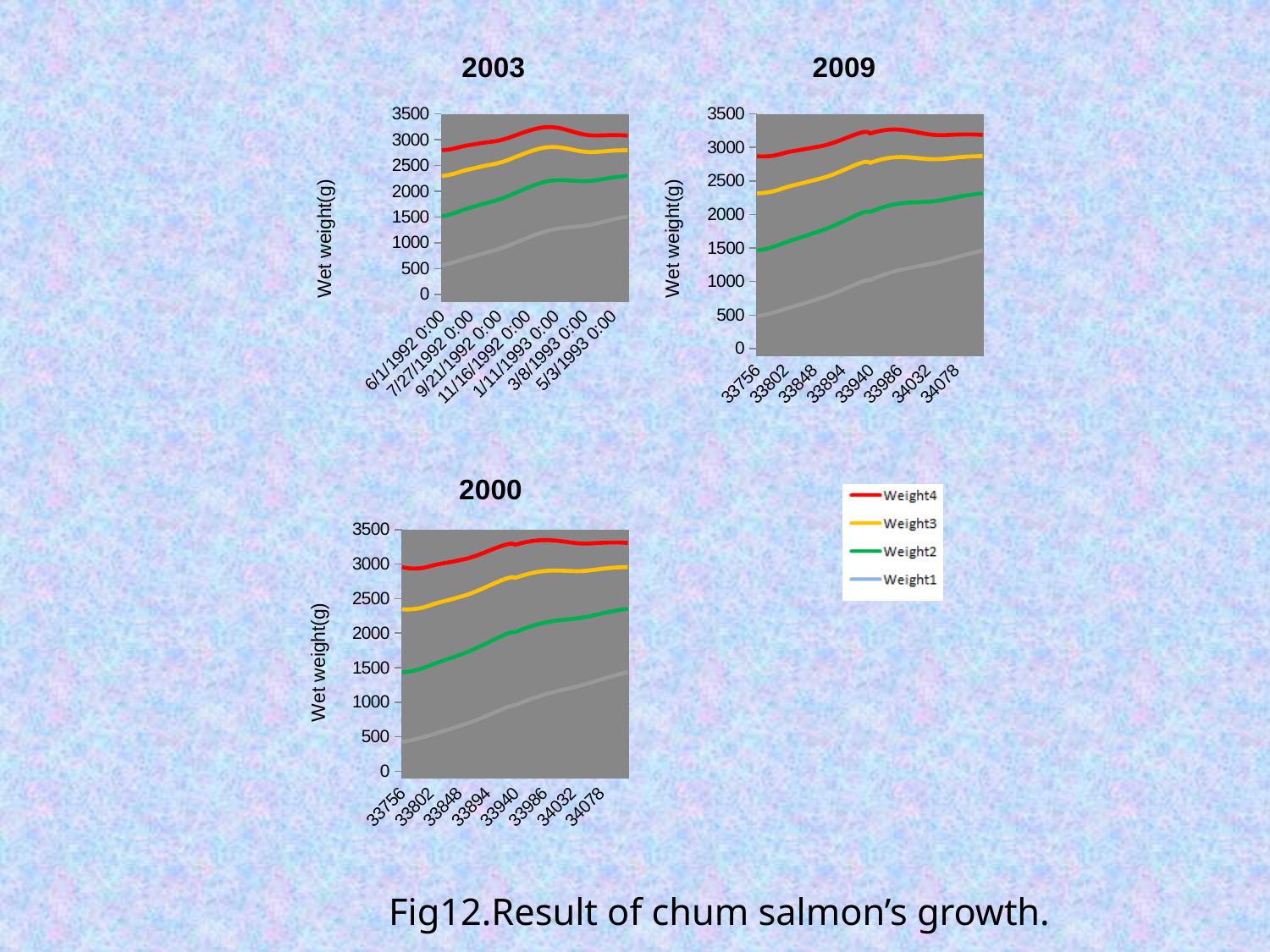
In the chart titled 2000, is the value of Weight4 at the last point greater or less than 3000? greater How many series does the legend list? 4 In the chart titled 2009, is the value of Weight3 at the first point greater or less than 2000? greater What kind of chart is the chart titled 2003? line chart In the chart titled 2009, which series has the highest values? Weight4 In the chart titled 2003, does the Weight1 line generally rise or fall along the x axis? rise In the chart titled 2003, which is larger at the first point, Weight2 or Weight3? Weight3 What colour is the Weight2 line in the legend? green What is the y-axis label on the chart titled 2000? Wet weight(g) In the chart titled 2000, which series has the lowest values? Weight1 How many x-axis labels are shown on the chart titled 2009? 8